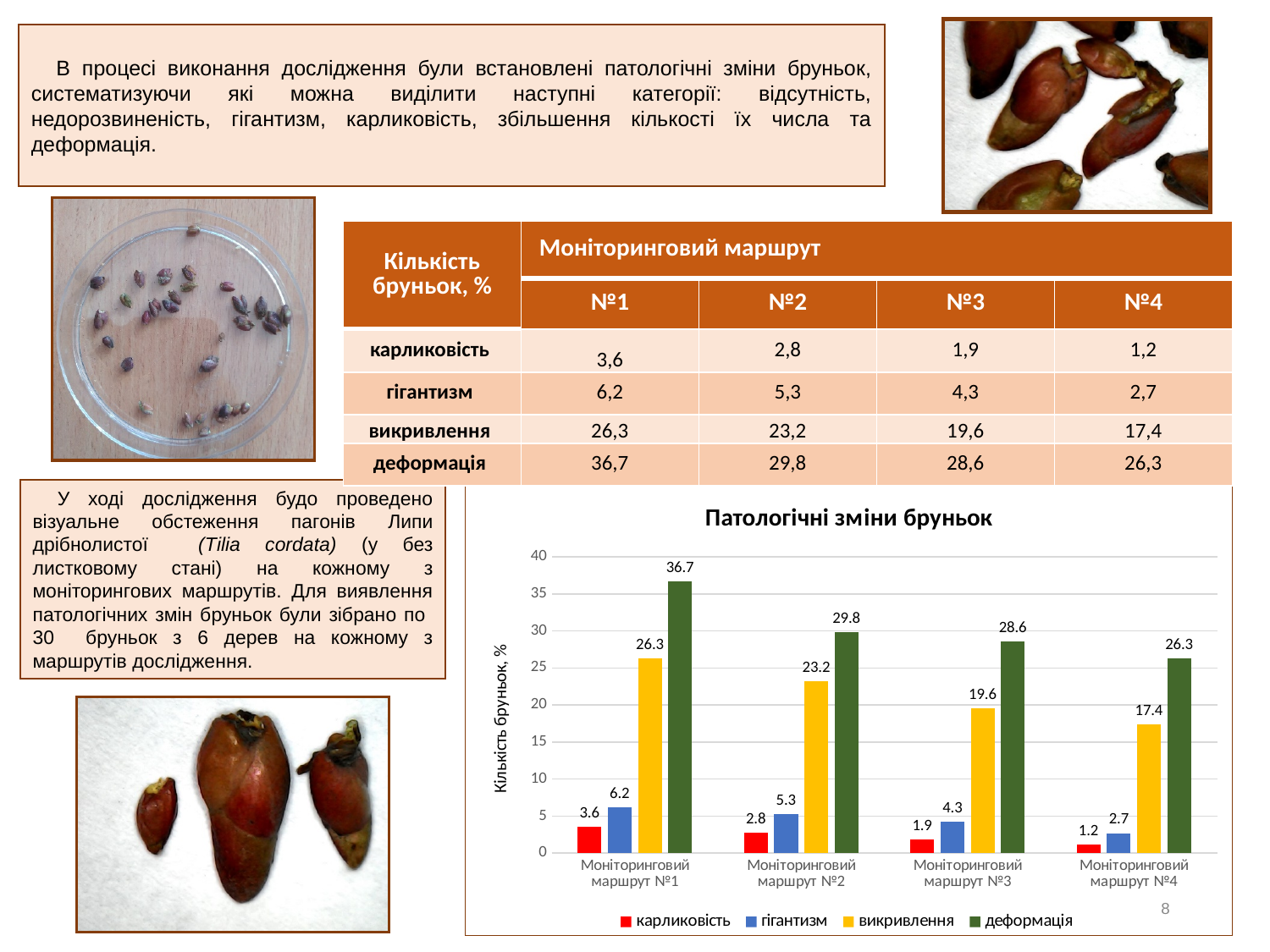
Which monitoring route has the lowest value for "гігантизм"? Моніторинговий маршрут №4 What is the label of the y axis of the chart "Патологічні зміни бруньок"? Кількість бруньок, % What is the difference between "деформація" and "викривлення" for "Моніторинговий маршрут №2"? 6.6 What is the value of "карликовість" for "Моніторинговий маршрут №4"? 1.2 Do the values of "викривлення" rise or fall from "Моніторинговий маршрут №1" to "Моніторинговий маршрут №4"? fall How many series does the legend of the chart "Патологічні зміни бруньок" list? 4 Which monitoring route has the highest value for "деформація"? Моніторинговий маршрут №1 What is the value of "деформація" for "Моніторинговий маршрут №1"? 36.7 Which is larger: "гігантизм" for "Моніторинговий маршрут №1" or "гігантизм" for "Моніторинговий маршрут №3"? Моніторинговий маршрут №1 What is the value of "викривлення" for "Моніторинговий маршрут №3"? 19.6 What type of chart is shown under the title "Патологічні зміни бруньок"? bar chart How many monitoring route categories are shown on the x axis of the chart? 4